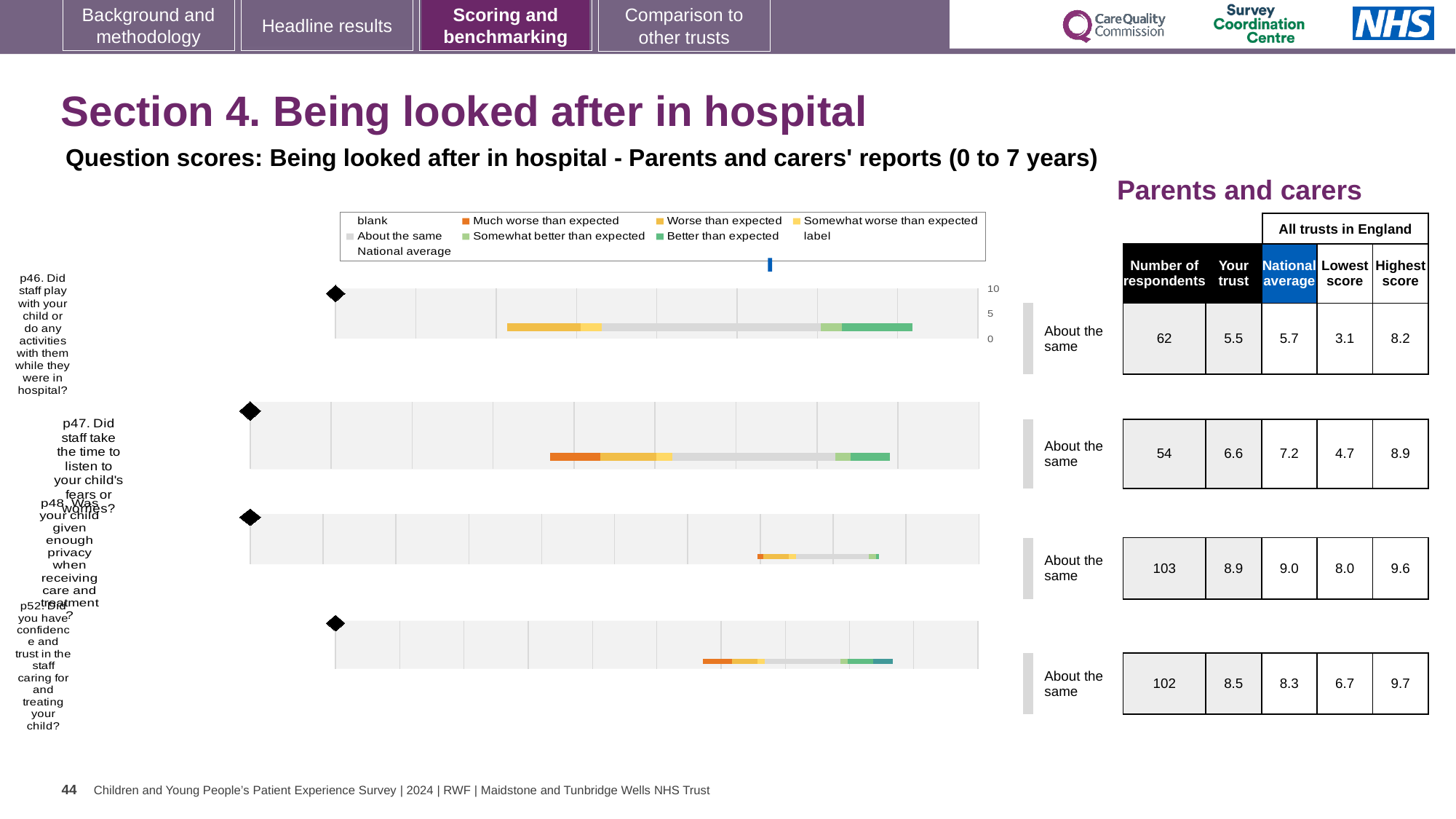
What benchmark category is shown next to each of the four question bars? About the same How many respondents answered question p48 (Was your child given enough privacy when receiving care and treatment?)? 103 Which question has the lowest 'Your trust' score? p46 How many survey questions (bars) are plotted on this slide? 4 What is the highest score across all trusts in England for question p52 (Did you have confidence and trust in the staff caring for and treating your child?)? 9.7 Is the 'Your trust' score for question p46 greater or less than 5? greater What is the 'Your trust' score for question p46 (Did staff play with your child or do any activities with them while they were in hospital?)? 5.5 What is the difference between the highest score and the lowest score for question p47? 4.2 What is the national average score for question p47 (Did staff take the time to listen to your child's fears or worries?)? 7.2 Which question has the highest 'Your trust' score? p48 What kind of chart is used to show the question scores on this slide? bar chart For question p52, which is larger: the 'Your trust' score or the national average? Your trust